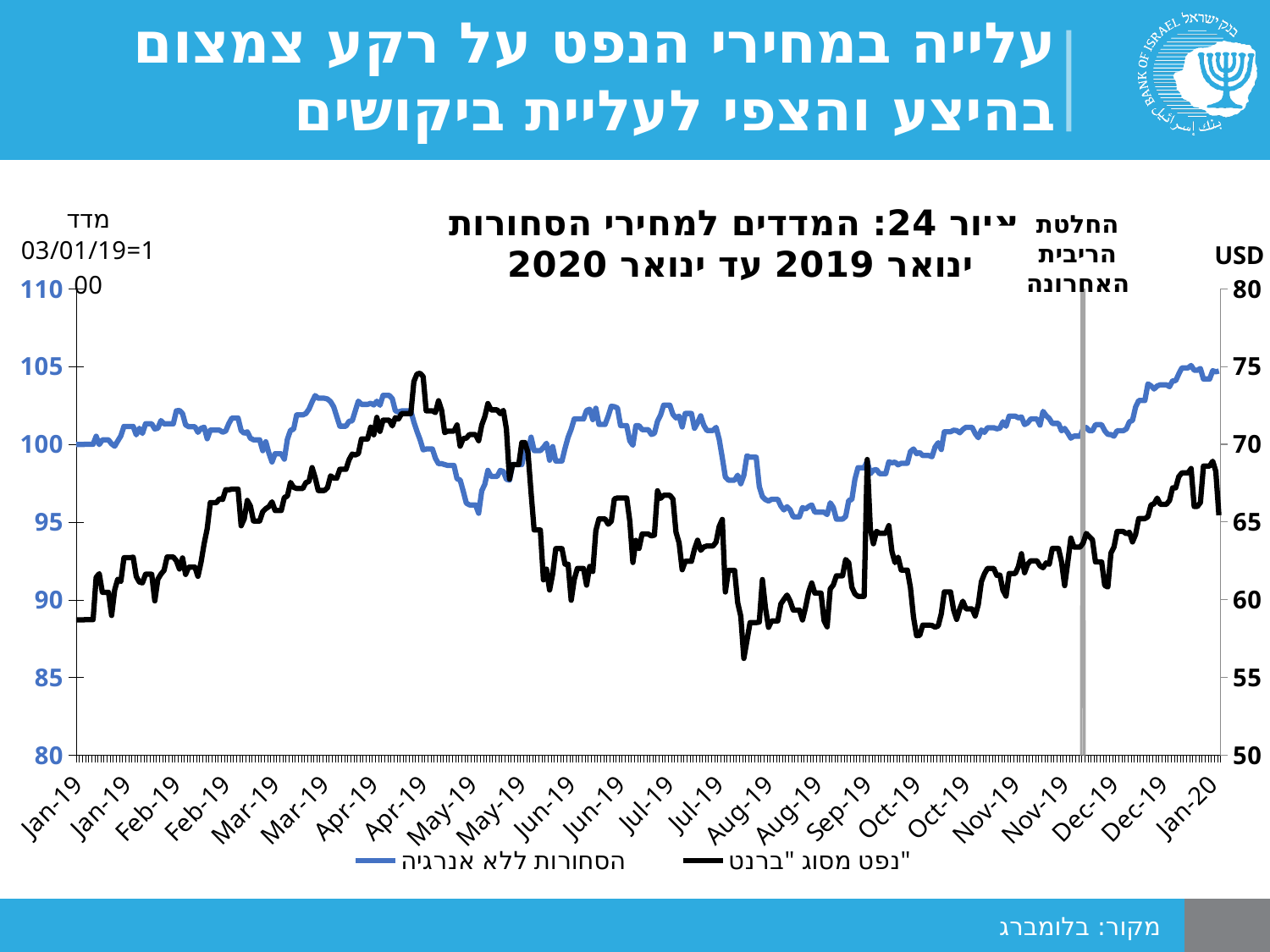
What is the unit shown on the right-hand axis of the chart? USD Is the value of the Brent oil series (נפט מסוג ברנט) at the start of Jan-19 greater or less than 60 USD? less Is the peak value of the Brent oil series (נפט מסוג ברנט) in late Apr-19 greater or less than 70 USD? greater Is the lowest value of the Brent oil series (נפט מסוג ברנט) in Aug-19 greater or less than 60 USD? less What kind of chart is shown on the slide? line chart What is the title of the chart? איור 24: המדדים למחירי הסחורות ינואר 2019 עד ינואר 2020 Does the Brent oil series (נפט מסוג ברנט) rise or fall between late Apr-19 and early Aug-19? fall What is the source cited for the chart? בלומברג Does the non-energy commodities series (הסחורות ללא אנרגיה) rise or fall between Sep-19 and Jan-20? rise How many series does the legend list? 2